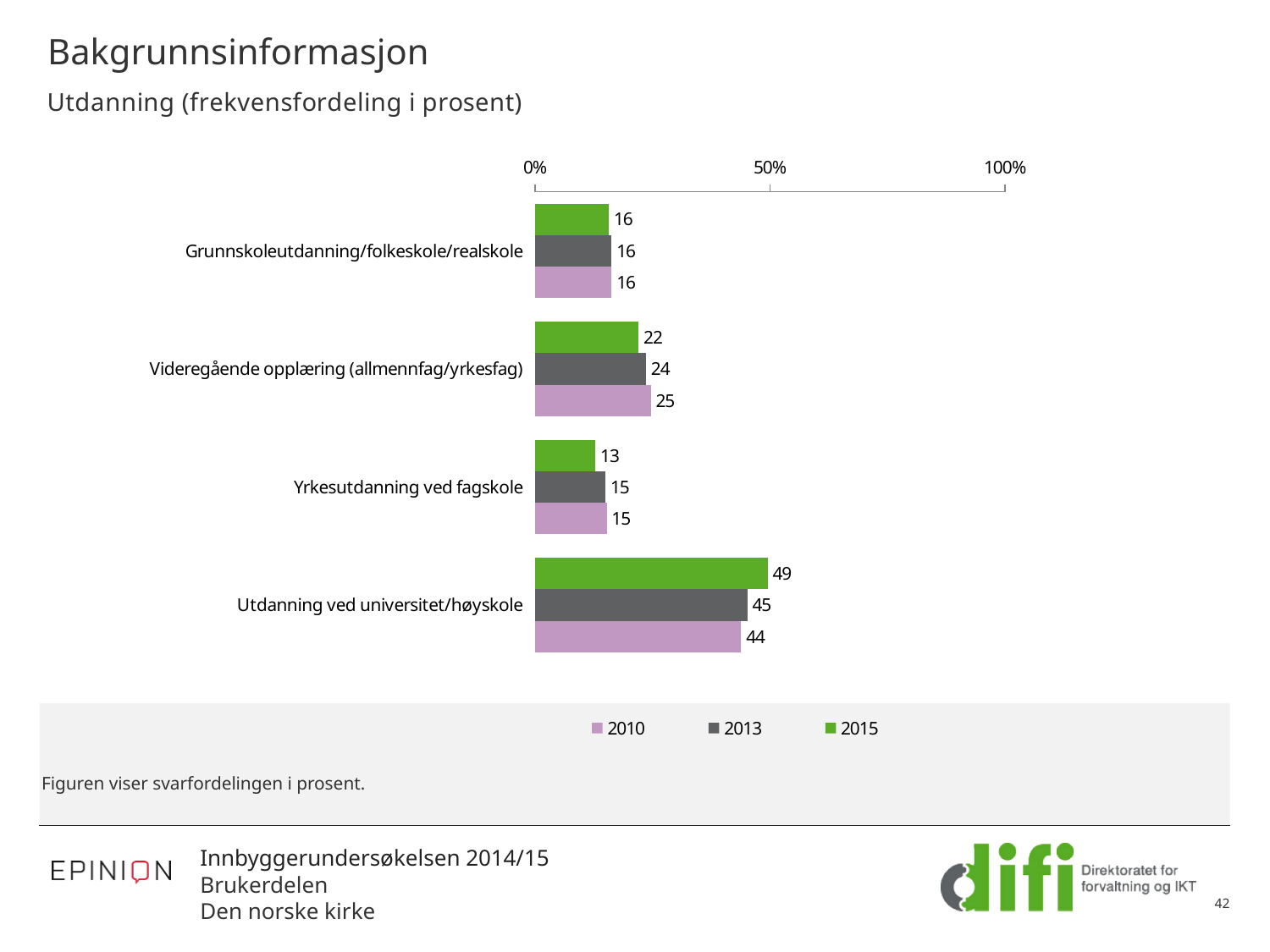
What is the value for Yrkesutdanning ved fagskole in 2013? 15 What is the value for Grunnskoleutdanning/folkeskole/realskole in 2013? 16 Is the value for Utdanning ved universitet/høyskole in 2013 greater or less than 50%? less How many series does the legend list? 3 What is the value for Videregående opplæring (allmennfag/yrkesfag) in 2010? 25 Which is larger for Videregående opplæring (allmennfag/yrkesfag): the 2010 value or the 2015 value? 2010 What is the difference between the 2015 and 2010 values for Utdanning ved universitet/høyskole? 5 What kind of chart is shown on the slide? Bar chart What is the value for Utdanning ved universitet/høyskole in 2015? 49 Which category has the highest value in 2015? Utdanning ved universitet/høyskole How many education categories are shown in the chart? 4 Which category has the lowest value in 2015? Yrkesutdanning ved fagskole